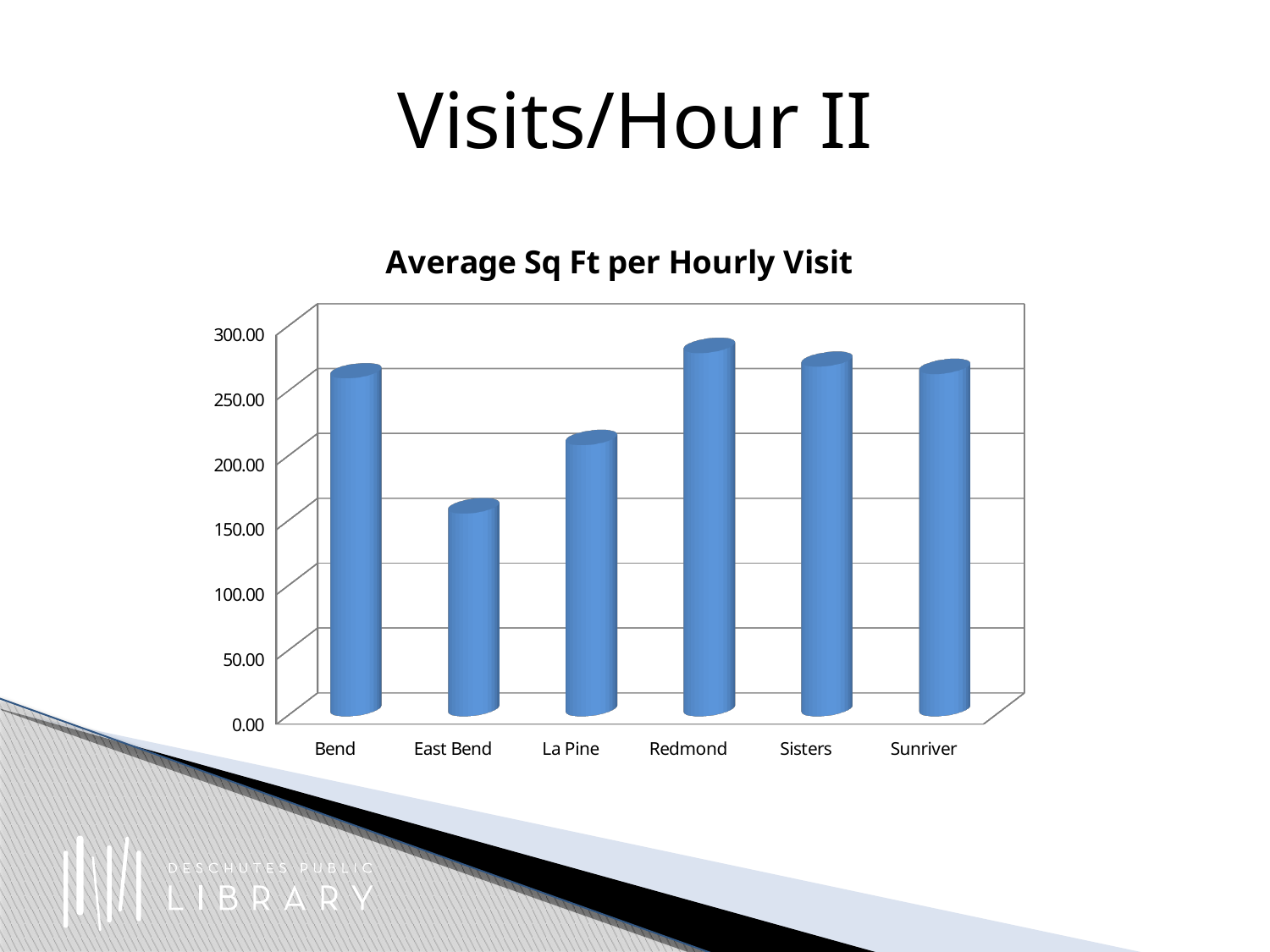
How many branches (categories) are shown on the x axis of the chart? 6 Which is larger, the value for East Bend or the value for Sunriver? Sunriver Is the value for East Bend greater or less than 200.00? less Is the value for Sisters greater or less than 200.00? greater Which branch has the highest average sq ft per hourly visit? Redmond Which branch has the lowest average sq ft per hourly visit? East Bend Which is larger, the value for Bend or the value for La Pine? Bend Is the value for East Bend greater or less than 100.00? greater What type of chart is shown on the slide? bar chart What is the title of the chart? Average Sq Ft per Hourly Visit